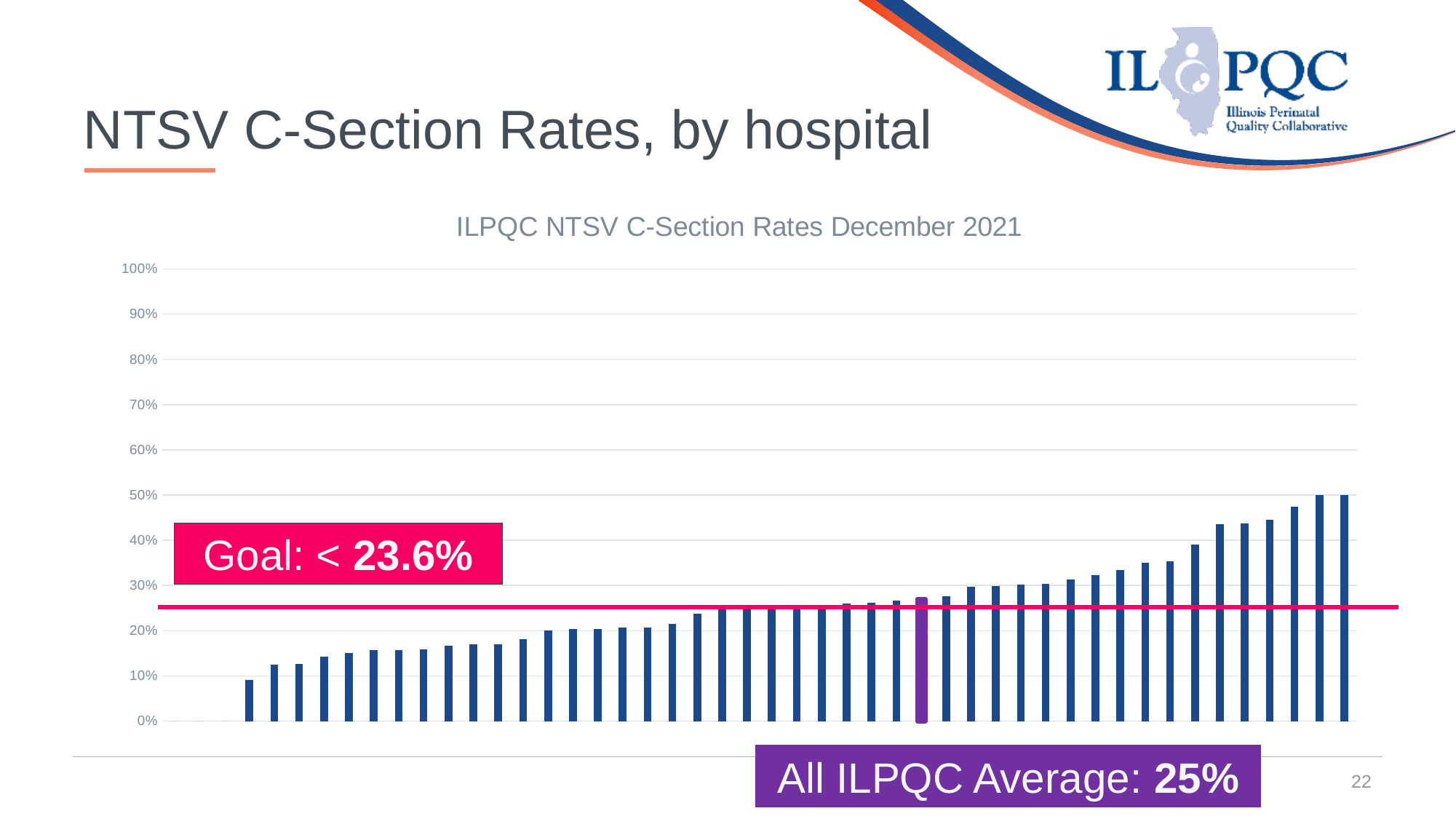
What is the All ILPQC Average NTSV C-Section rate shown on the chart? 25% Is the value of the leftmost bar greater or less than 10%? less Is the All ILPQC Average of 25% greater or less than the goal of 23.6%? greater Is the value of the tallest bar greater or less than 30%? greater Which bar is the highest: the leftmost bar or the rightmost bar? The rightmost bar Do the bar values rise or fall from left to right along the x axis? Rise What is the highest value shown on the y axis? 100% What kind of chart is shown on the slide? Bar chart Is the value of the rightmost bar greater or less than 40%? greater What goal rate is marked by the horizontal line on the chart? < 23.6% What is the title of the chart? ILPQC NTSV C-Section Rates December 2021